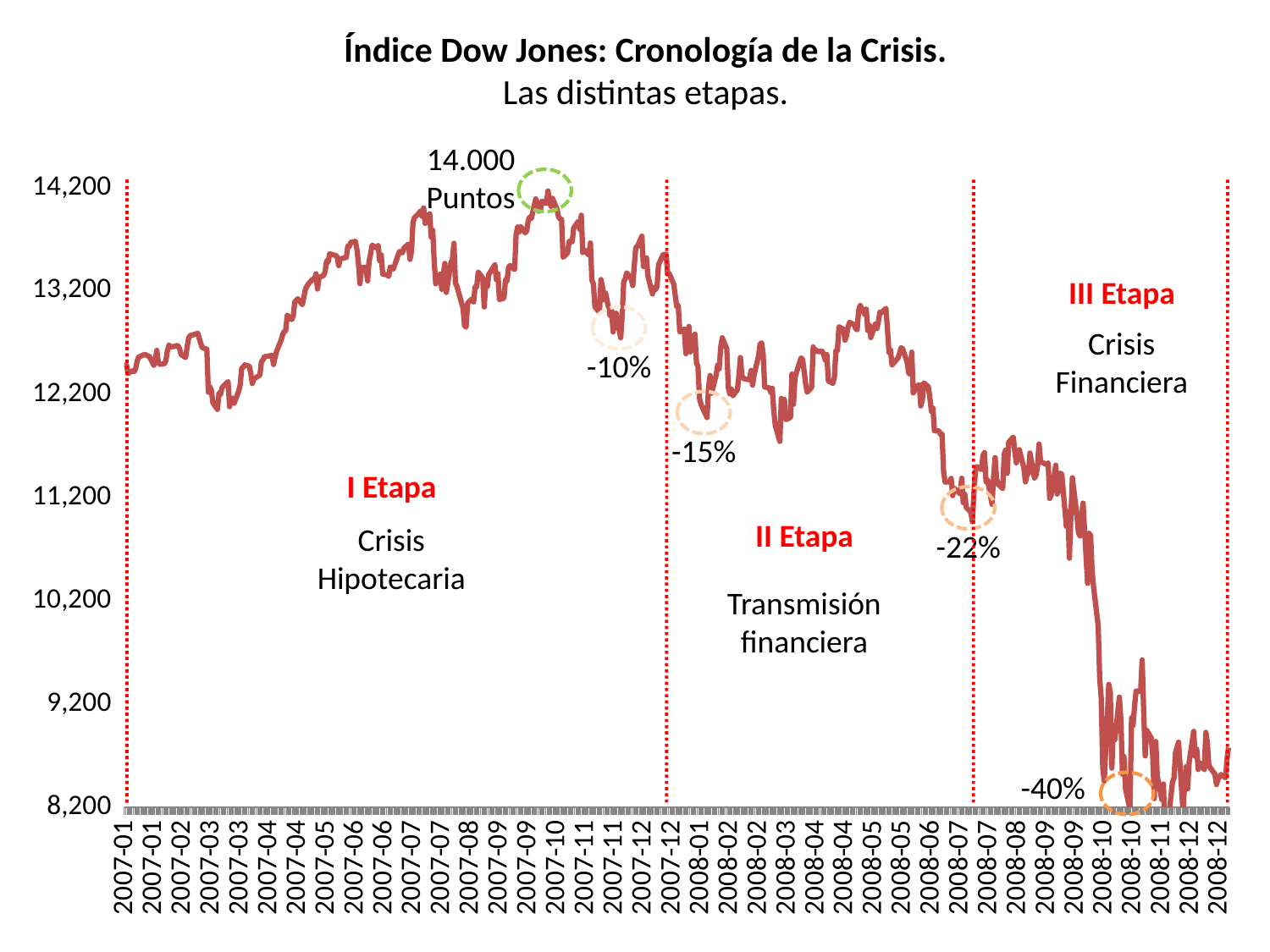
What is the title of the chart? Índice Dow Jones: Cronología de la Crisis. Las distintas etapas. Which stage is labelled 'Crisis Hipotecaria'? I Etapa Overall, does the Dow Jones index rise or fall from 2007-01 to 2008-12? Fall What percentage drop is annotated near 2007-11? -10% How many stages (Etapas) are marked on the chart? 3 What percentage drop is annotated near 2008-07? -22% What percentage drop is annotated near 2008-10? -40% What percentage drop is annotated near 2008-01? -15% What peak value is annotated on the chart in 2007-10? 14.000 Puntos Is the value of the index in 2007-10 greater or less than 13,200? greater What kind of chart is shown on the slide? Line chart